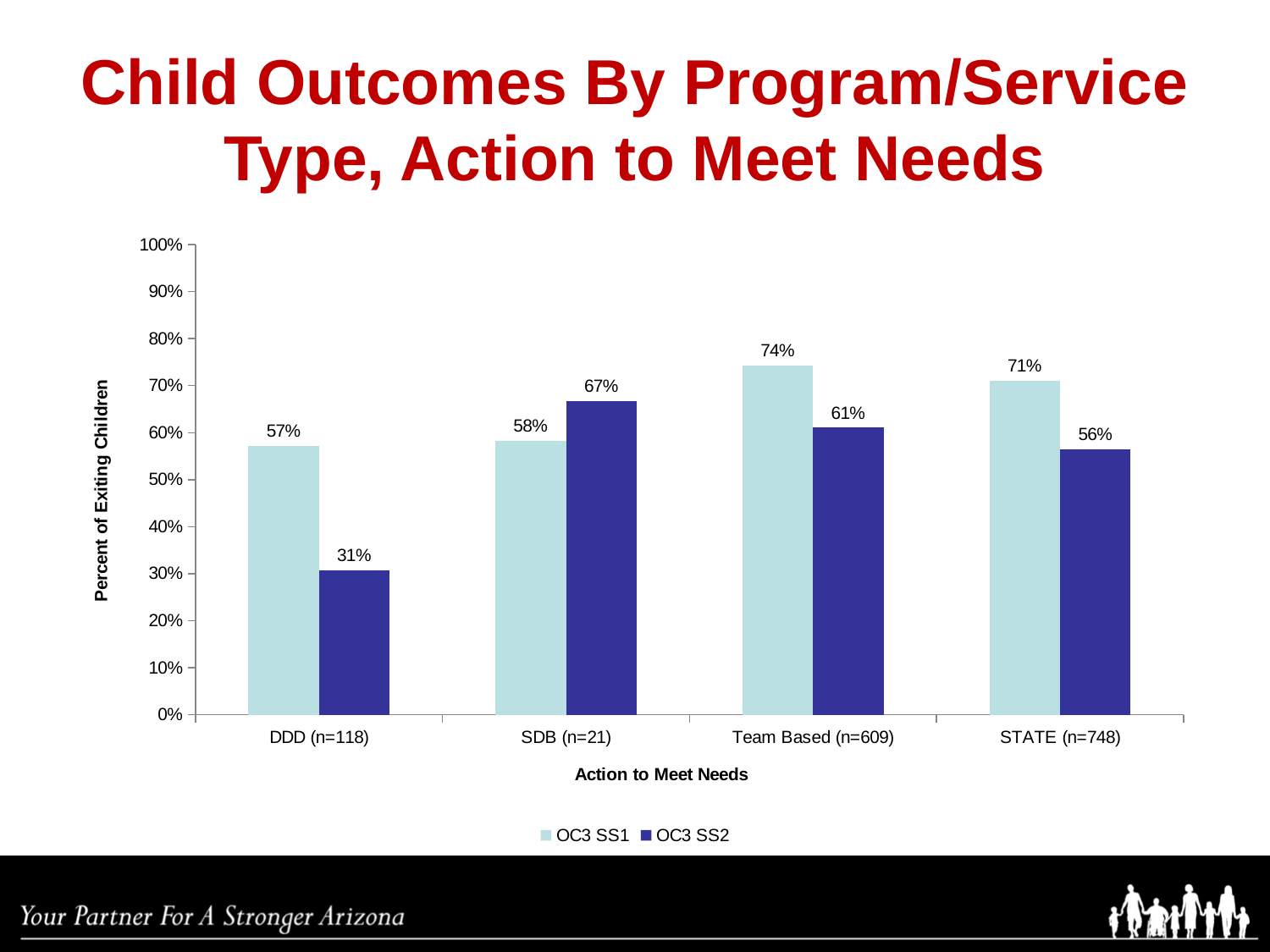
How many series does the legend list? 2 What is the difference between the OC3 SS1 and OC3 SS2 values for DDD (n=118)? 26% How many categories are shown on the x axis? 4 What is the OC3 SS1 value for DDD (n=118)? 57% Which category has the lowest OC3 SS2 value? DDD (n=118) What is the OC3 SS2 value for STATE (n=748)? 56% Which category has the highest OC3 SS1 value? Team Based (n=609) What kind of chart is shown on the slide? Bar chart For SDB (n=21), which series has the larger value, OC3 SS1 or OC3 SS2? OC3 SS2 What is the OC3 SS1 value for Team Based (n=609)? 74% What is the label of the y axis? Percent of Exiting Children What is the OC3 SS2 value for SDB (n=21)? 67%